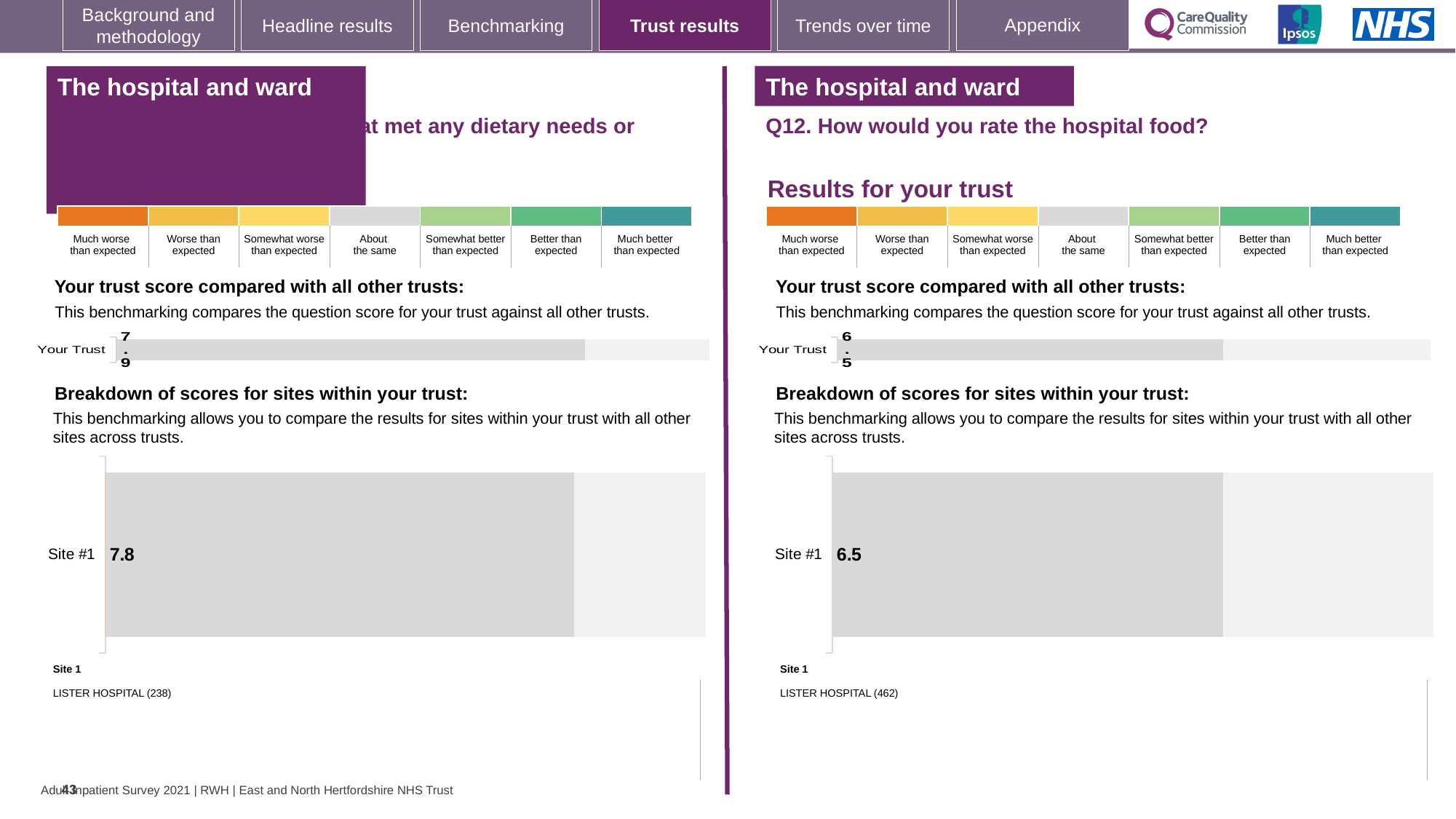
On the right half of the slide (Q12), is the Your Trust score equal to the Site #1 score? Yes, both are 6.5 What is the difference between the Site #1 score on the left half of the slide and the Site #1 score on the right half (Q12)? 1.3 On the right half of the slide (Q12. How would you rate the hospital food?), what is the score shown for Site #1? 6.5 How many sites are shown in the 'Breakdown of scores for sites within your trust' chart on the right half of the slide (Q12)? 1 On the right half of the slide (Q12. How would you rate the hospital food?), what is the score shown for Your Trust? 6.5 On the left half of the slide, what is the score shown for Your Trust in the 'Your trust score compared with all other trusts' chart? 7.9 On the left half of the slide, which site name is listed as Site 1 below the chart? LISTER HOSPITAL (238) On the left half of the slide, what is the difference between the Your Trust score and the Site #1 score? 0.1 On the right half of the slide (Q12), which site name is listed as Site 1 below the chart? LISTER HOSPITAL (462) What kind of chart is used to show the Site #1 score on the right half of the slide (Q12)? Bar chart Which is larger: the Your Trust score on the left half of the slide or the Your Trust score on the right half (Q12)? The left half (7.9) On the left half of the slide, what is the score shown for Site #1 in the 'Breakdown of scores for sites within your trust' chart? 7.8